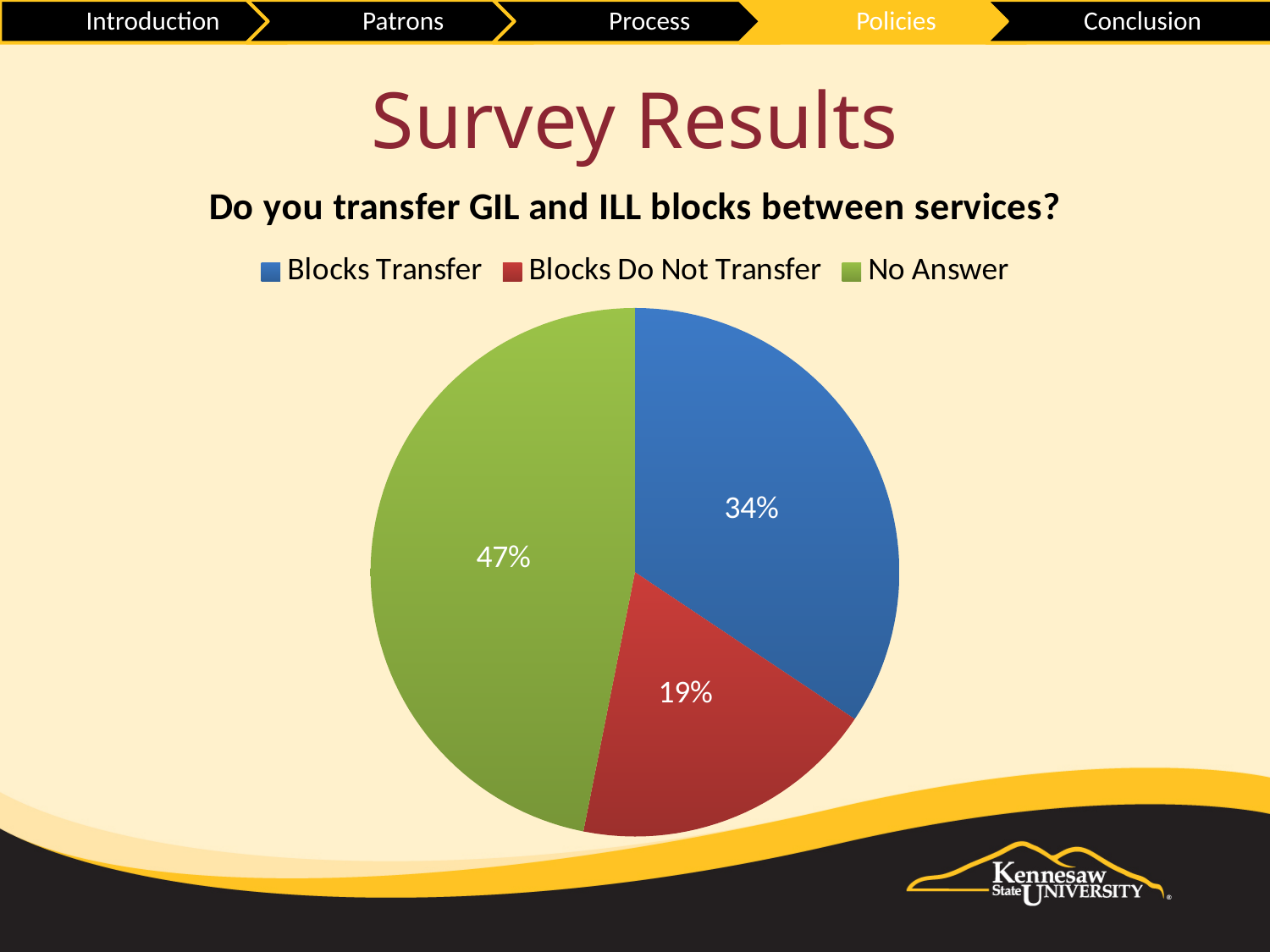
Which category has the smallest share of the pie? Blocks Do Not Transfer What is the difference in percentage points between Blocks Transfer and Blocks Do Not Transfer? 15 What is the difference in percentage points between No Answer and Blocks Transfer? 13 What percentage of respondents gave no answer? 47% What colour is the slice for No Answer? green What is the title of the chart? Do you transfer GIL and ILL blocks between services? What percentage of respondents said blocks do not transfer? 19% Which is larger, the share for Blocks Transfer or the share for Blocks Do Not Transfer? Blocks Transfer What percentage of respondents said blocks transfer? 34% What kind of chart is shown on the slide? pie chart How many categories does the legend list? 3 Which category has the largest share of the pie? No Answer